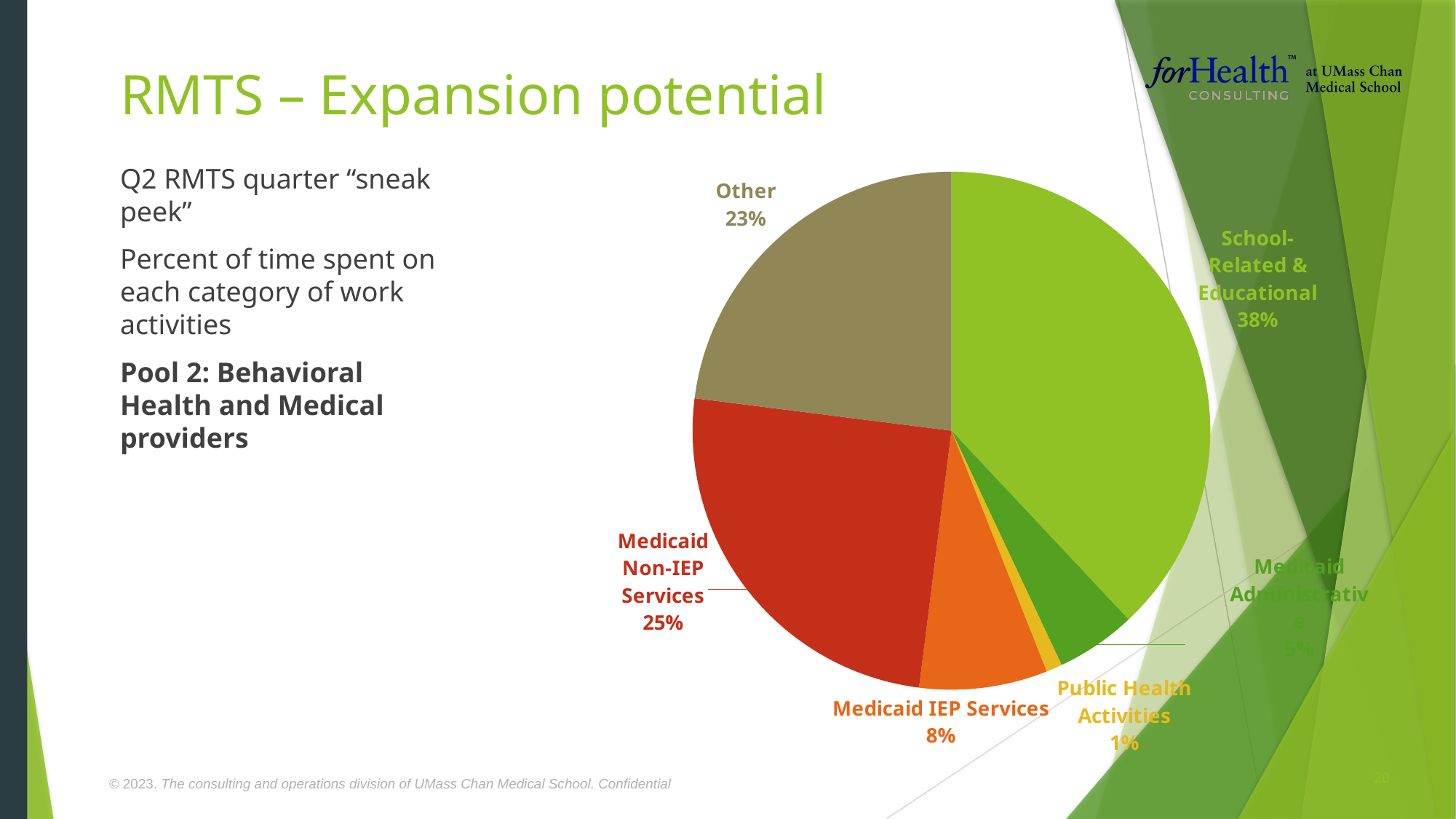
Which category has the largest share of time? School-Related & Educational Which category has the smallest share of time? Public Health Activities What percentage of time is spent on School-Related & Educational activities? 38% What kind of chart is shown on the slide? Pie chart What is the difference between the share for School-Related & Educational and the share for Medicaid Non-IEP Services? 13% Which is larger, the share for Other or the share for Medicaid IEP Services? Other What percentage of time is spent on Public Health Activities? 1% What percentage of time is spent on the Other category? 23% What percentage of time is spent on Medicaid IEP Services? 8% Which pool of providers does the pie chart describe? Pool 2: Behavioral Health and Medical providers What percentage of time is spent on Medicaid Non-IEP Services? 25% How many categories are shown in the pie chart? 6